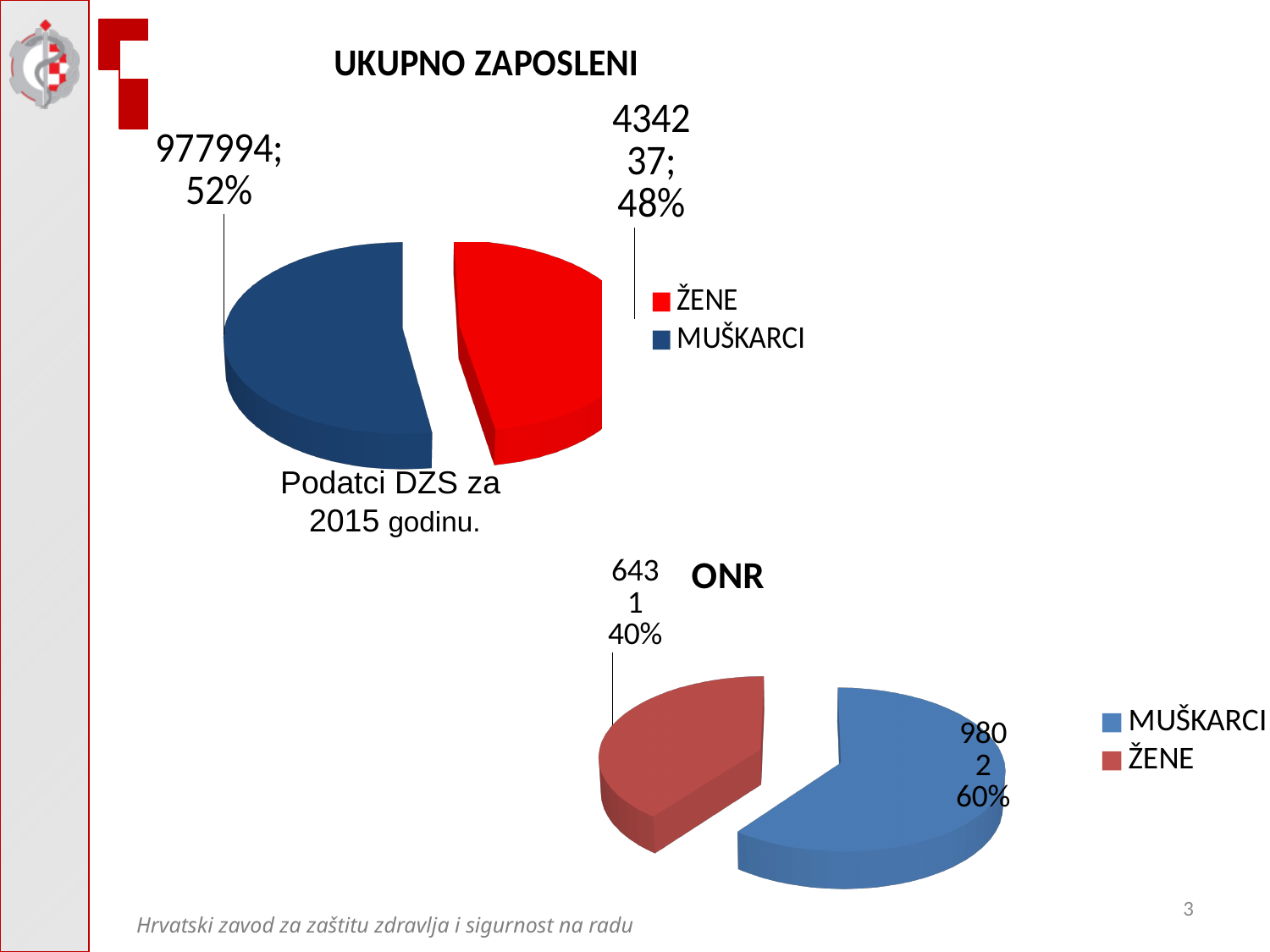
In the UKUPNO ZAPOSLENI chart, what share of the pie is ŽENE? 48% In the ONR chart, what share of the pie is MUŠKARCI? 60% In the ONR chart, which category has the smaller slice? ŽENE In the UKUPNO ZAPOSLENI chart, what is the value for MUŠKARCI? 977994 In the UKUPNO ZAPOSLENI chart, which category has the larger slice? MUŠKARCI In the UKUPNO ZAPOSLENI chart, what share of the pie is MUŠKARCI? 52% In the ONR chart, what colour is the ŽENE slice? Red How many categories does the legend of the UKUPNO ZAPOSLENI chart list? 2 In the ONR chart, is the slice for MUŠKARCI larger or smaller than the slice for ŽENE? Larger What kind of chart is the UKUPNO ZAPOSLENI chart? Pie chart How many pie charts are shown on the slide? 2